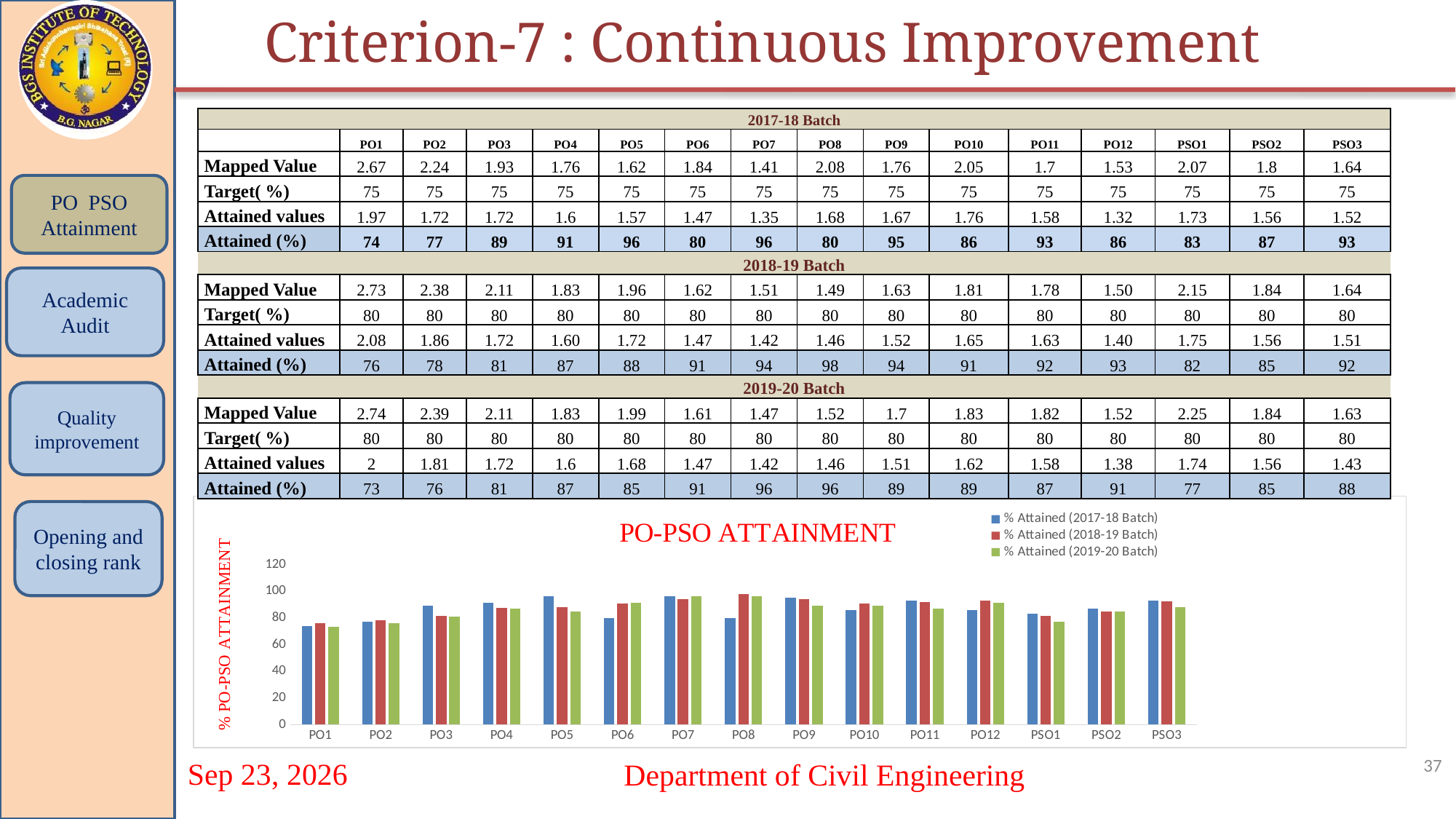
How many series does the legend of the PO-PSO ATTAINMENT chart list? 3 What is the label on the vertical axis of the PO-PSO ATTAINMENT chart? % PO-PSO ATTAINMENT What kind of chart is the PO-PSO ATTAINMENT chart? bar chart What is the % Attained for PO5 in the 2017-18 Batch? 96 What is the title of the chart on the slide? PO-PSO ATTAINMENT In the PO-PSO ATTAINMENT chart, is the value for PSO1 in the 2019-20 Batch greater or less than 80? less How many categories are shown on the x axis of the PO-PSO ATTAINMENT chart? 15 What is the difference between the % Attained for PO8 in the 2018-19 Batch and PO1 in the 2017-18 Batch? 24 In the PO-PSO ATTAINMENT chart, is the value for PO1 in the 2017-18 Batch greater or less than 80? less In the PO-PSO ATTAINMENT chart, is the value for PO8 in the 2018-19 Batch greater or less than 80? greater Which category has the highest % Attained in the 2018-19 Batch? PO8 Which category has the lowest % Attained in the 2017-18 Batch? PO1